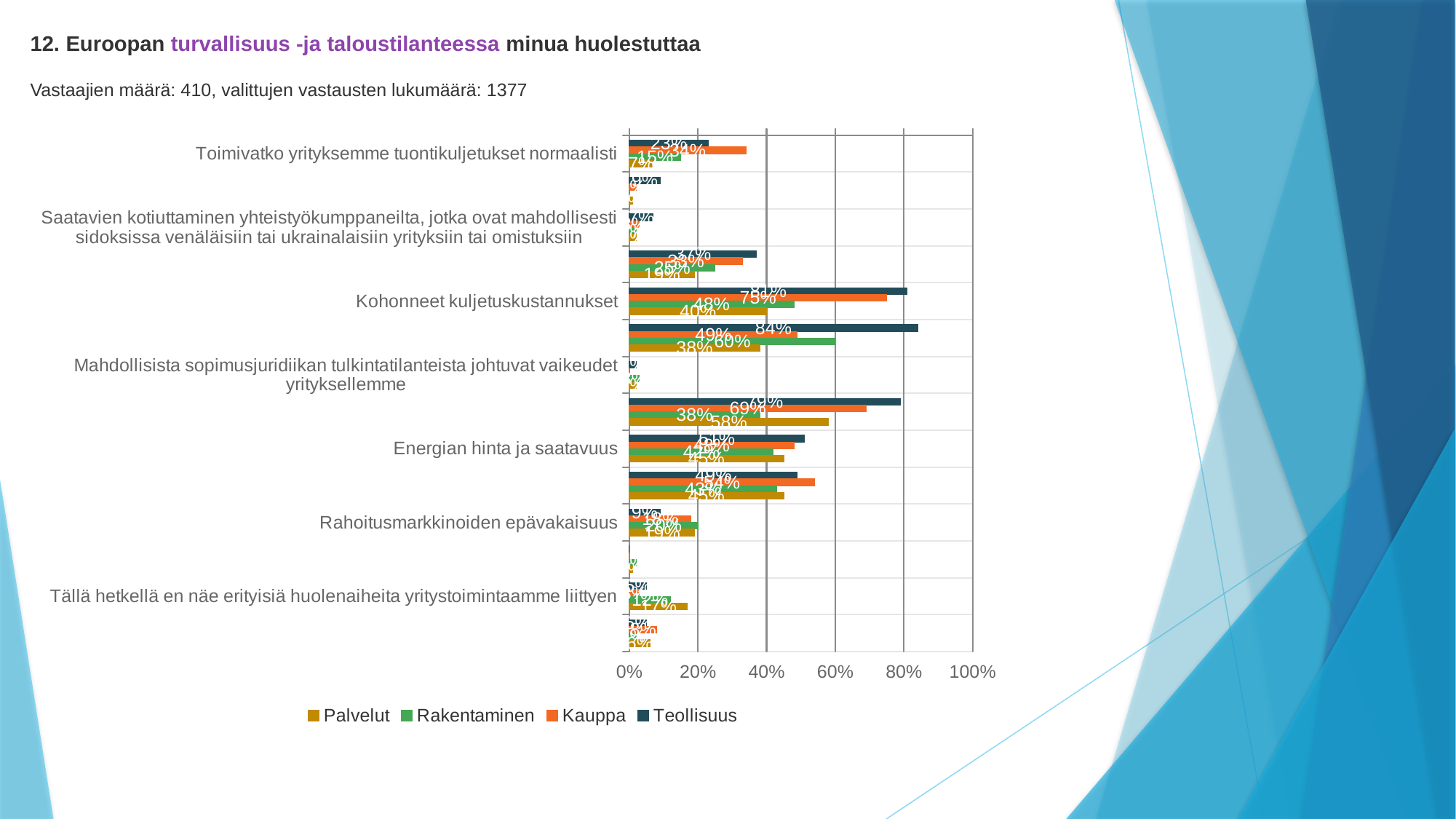
Which series is listed first in the legend? Palvelut Is the longest bar on the chart greater or less than 80%? greater What kind of chart is shown on the slide? bar chart Which series does the longest bar on the chart belong to? Teollisuus What is the maximum value shown on the x axis? 100% How many selected answers (valittujen vastausten lukumäärä) are stated above the chart? 1377 What is the highest value printed as a data label on the chart? 84% How many respondents (Vastaajien määrä) are stated above the chart? 410 Which series is listed last in the legend? Teollisuus How many series does the legend list? 4